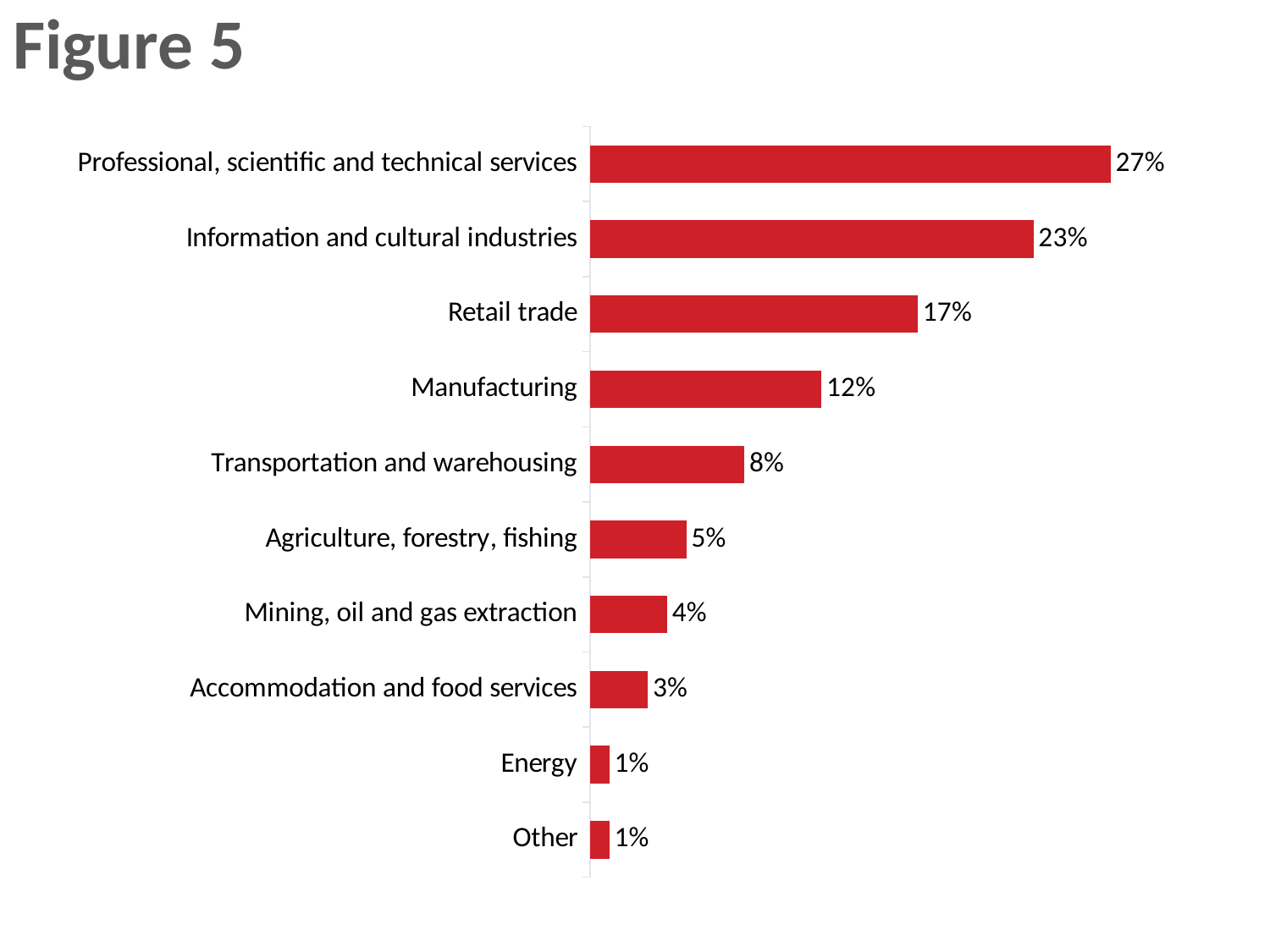
What is the value for Accommodation and food services? 3% Which is larger, Manufacturing or Mining, oil and gas extraction? Manufacturing What is the value for Transportation and warehousing? 8% What is the value for Retail trade? 17% What is the value for Professional, scientific and technical services? 27% What is the difference between Information and cultural industries and Manufacturing? 11% How many categories are shown in the chart? 10 Which category has the highest value? Professional, scientific and technical services What kind of chart is shown on the slide? Bar chart What is the difference between Retail trade and Agriculture, forestry, fishing? 12% Which is larger, Agriculture, forestry, fishing or Accommodation and food services? Agriculture, forestry, fishing What is the title of the slide? Figure 5